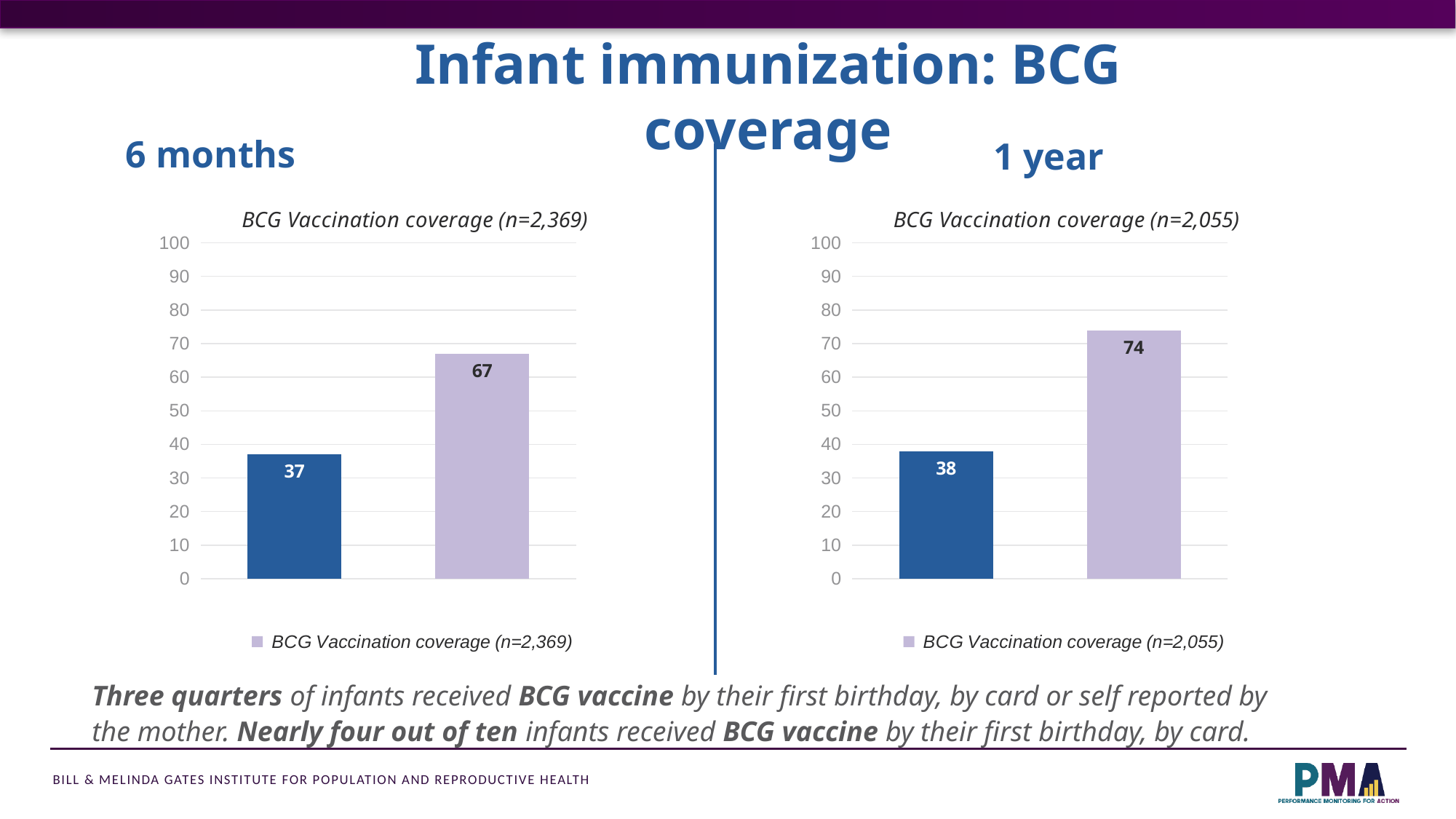
In the 1 year chart, what is the value of the right (purple) bar? 74 In the 6 months chart, which bar is higher, the blue bar or the purple bar? the purple bar How many bars are plotted in the 1 year chart? 2 What type of chart is the 1 year chart? bar chart How many series does the legend of the 6 months chart list? 1 In the 1 year chart, what is the difference between the two bars? 36 In the 6 months chart, what is the difference between the two bars? 30 What is the title of the chart under the 1 year heading? BCG Vaccination coverage (n=2,055) Is the purple bar in the 1 year chart greater or less than 70? greater In the 6 months chart, what is the value of the right (purple) bar? 67 In the 1 year chart, what is the value of the left (blue) bar? 38 In the 6 months chart, what is the value of the left (blue) bar? 37